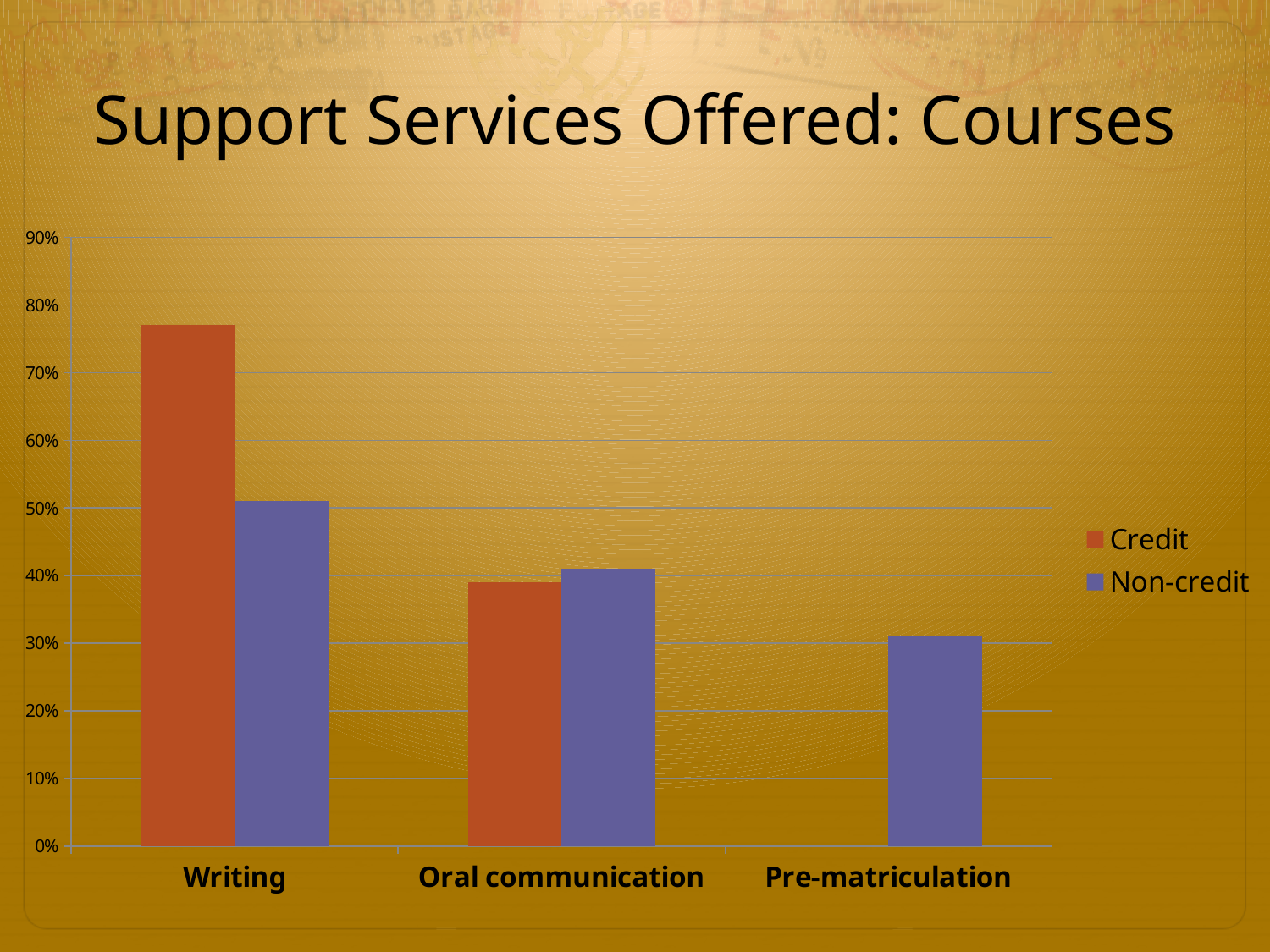
What kind of chart is shown on the slide? Bar chart Is the Non-credit value for Writing greater or less than 60%? less Which category has the highest Non-credit value? Writing Is the Credit value for Writing greater or less than 70%? greater What is the title of the chart? Support Services Offered: Courses Is the Non-credit value for Pre-matriculation greater or less than 40%? less How many categories are shown on the x axis? 3 For Writing, which is larger: the Credit value or the Non-credit value? Credit Which category has the highest Credit value? Writing Which category has the lowest Non-credit value? Pre-matriculation How many series does the legend list? 2